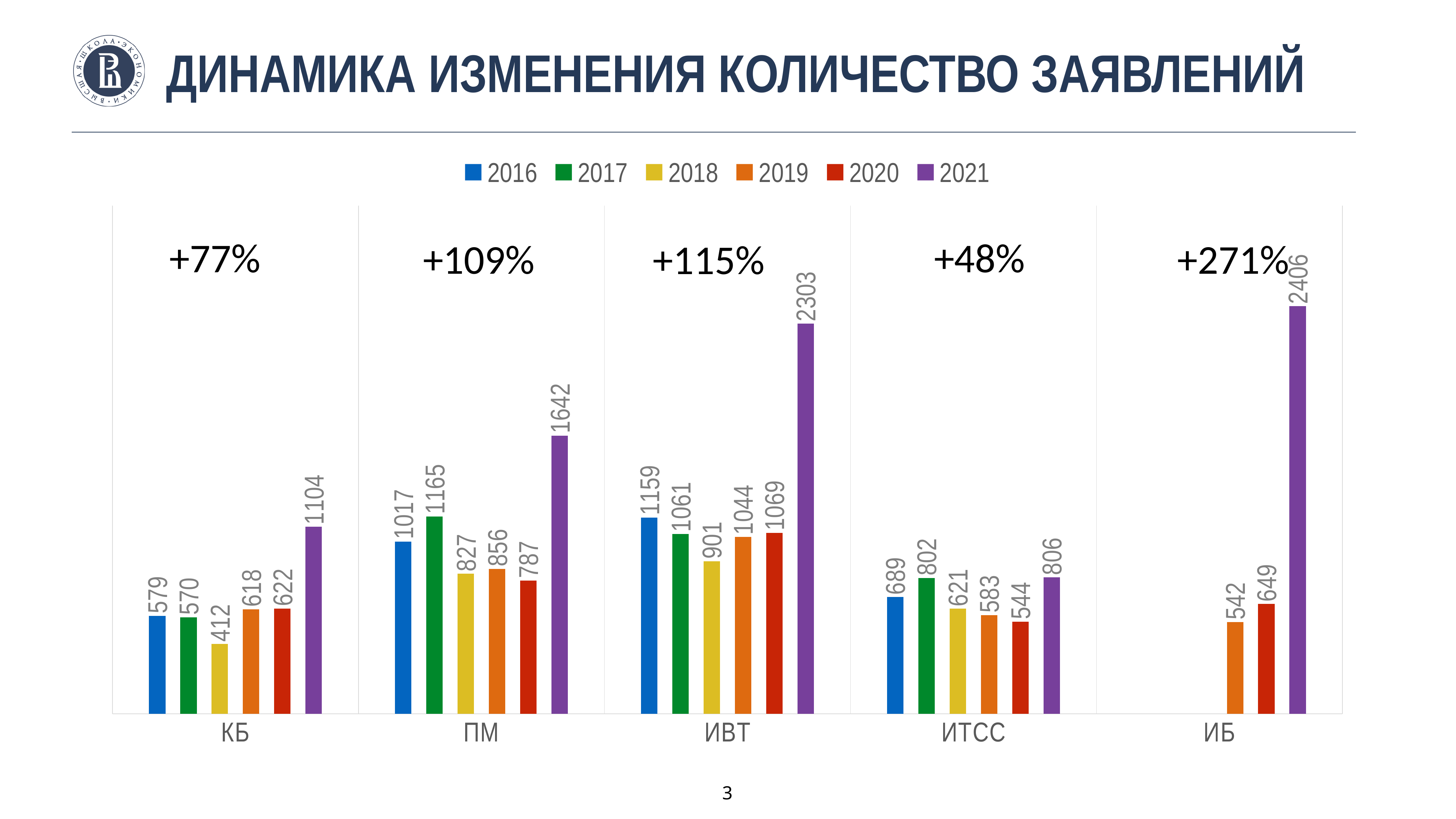
Which category has the lowest value in 2016? КБ Which is larger: the 2017 value for ИТСС or the 2017 value for КБ? ИТСС How many series does the legend list? 6 What kind of chart is shown on the slide? bar chart What is the value for ИВТ in 2021? 2303 What is the difference between the 2021 and 2020 values for ПМ? 855 How many categories are shown on the x axis? 5 Which category has the highest value in 2021? ИБ What is the value for ИБ in 2020? 649 What is the value for КБ in 2018? 412 Which colour represents the 2021 series in the legend? purple What percentage change is printed above the ИБ group? +271%